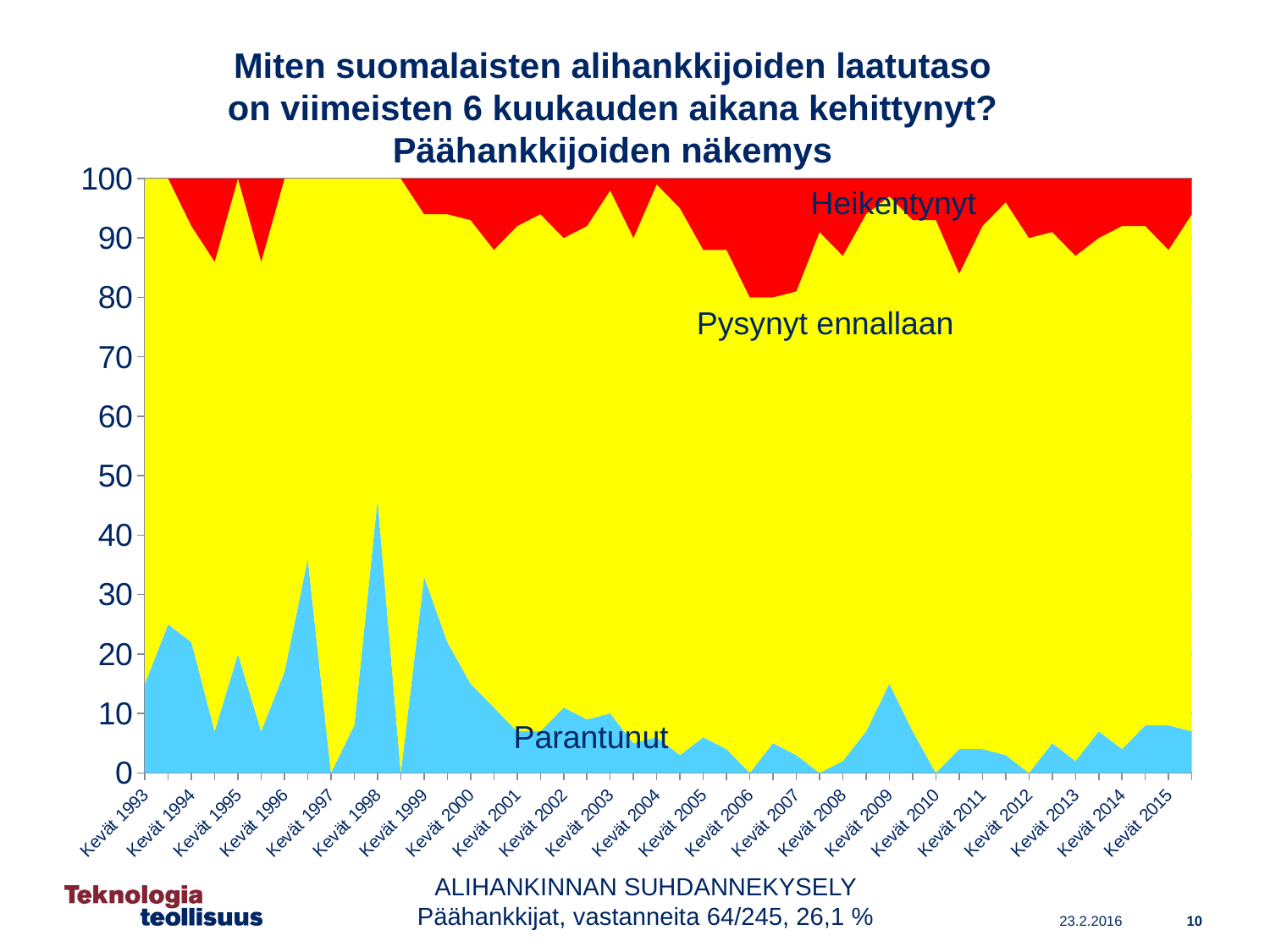
What kind of chart is shown on the slide? Stacked area chart In which year does the Parantunut series reach its highest value? Kevät 1998 Is the value for Parantunut at Kevät 2015 greater or less than 10? less How many Kevät labels are shown on the x axis? 23 Is the value for Parantunut at Kevät 2009 greater or less than 10? greater How many series are labelled in the chart? 3 Which series takes up the largest share of the chart area across the years? Pysynyt ennallaan Which series is shown in red at the top of the chart? Heikentynyt Does the Parantunut series rise or fall from Kevät 1999 to Kevät 2006? fall Is the value for Parantunut at Kevät 1998 greater or less than 40? greater Which series is labelled at the bottom of the chart in the blue area? Parantunut